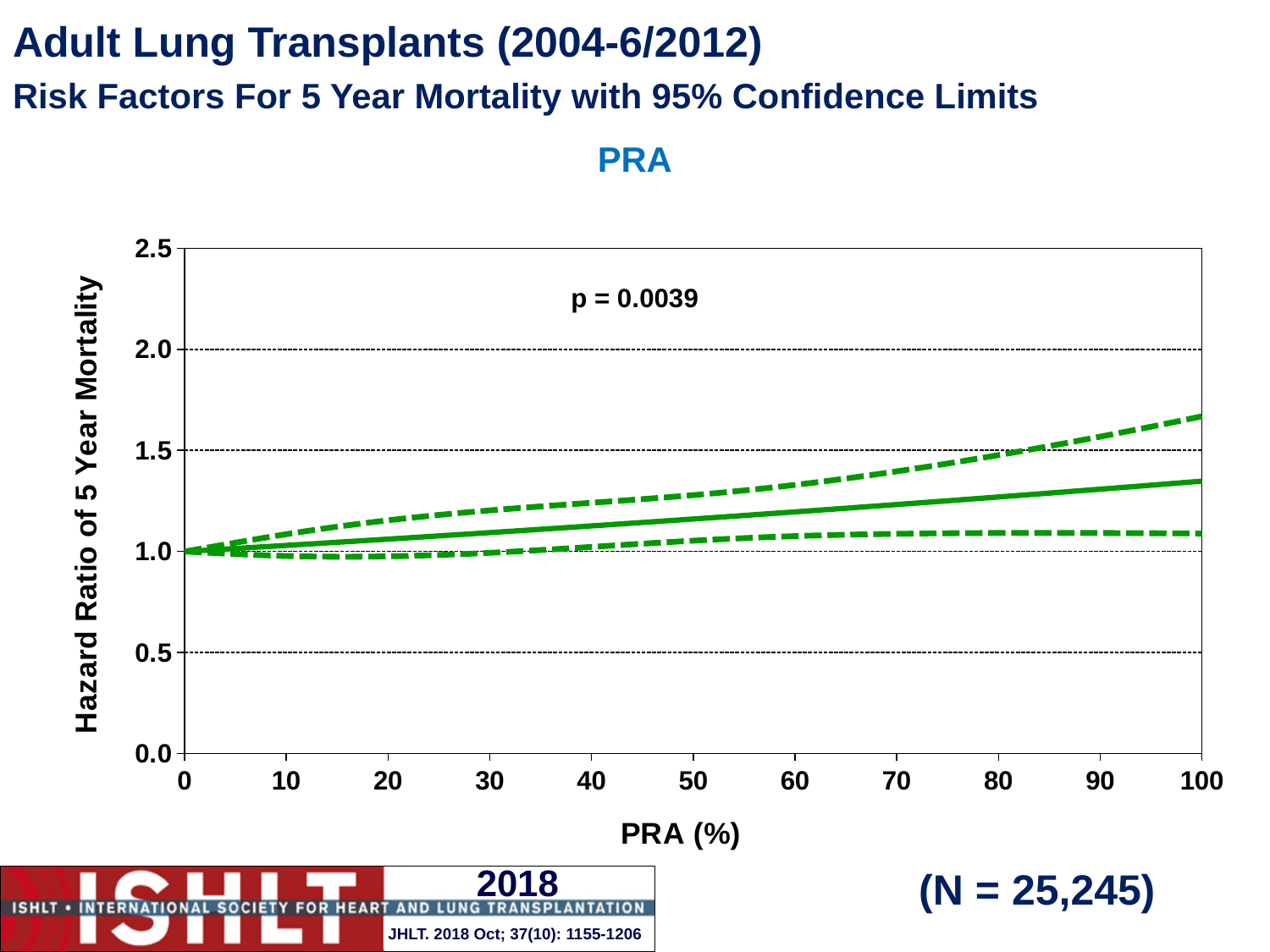
Is the value of the solid hazard ratio line at a PRA of 50% greater or less than 1.5? less What p-value is printed on the chart? p = 0.0039 Is the upper dashed confidence limit at a PRA of 100% greater or less than 1.5? greater Is the value of the solid hazard ratio line at a PRA of 100% greater or less than 1.0? greater What is the label of the x axis of the chart? PRA (%) How many lines are plotted on the chart? 3 Does the solid hazard ratio line rise or fall as PRA (%) increases from 0 to 100? rises What kind of chart is shown on the slide? line chart What is the hazard ratio of 5 year mortality at a PRA of 0%? 1.0